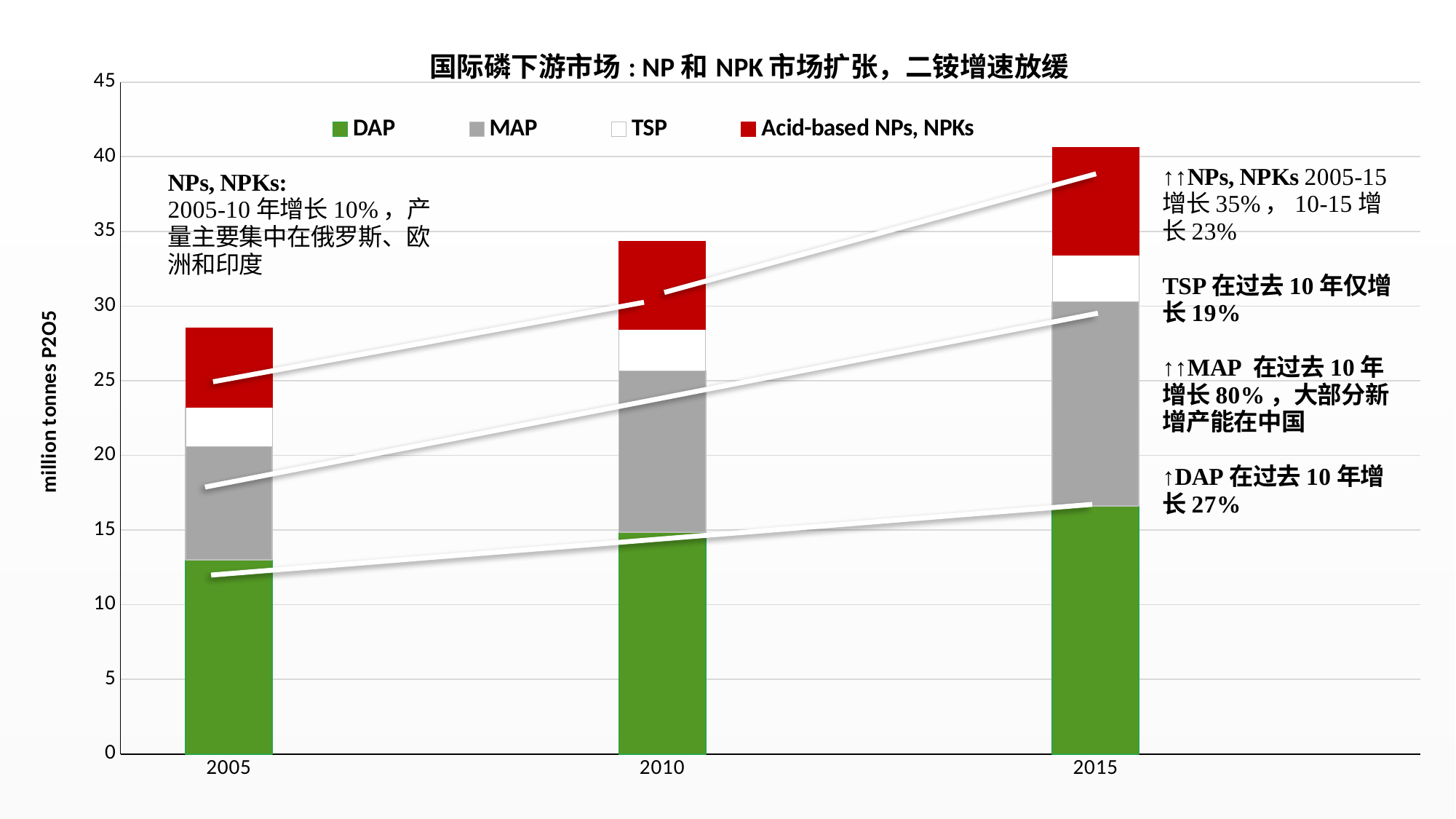
How many years are shown on the x axis of the chart? 3 What is the label on the vertical axis of the chart? million tonnes P2O5 Which year has the shortest stacked bar in the chart? 2005 What kind of chart is shown on the slide? Stacked bar chart Which year has the tallest stacked bar in the chart? 2015 Is the total stacked bar for 2005 greater or less than 30? less Is the total stacked bar for 2015 greater or less than 35? greater Do the total bar heights rise or fall from 2005 to 2015? Rise Which is larger, the MAP segment in 2005 or the MAP segment in 2015? 2015 Is the DAP segment for 2015 greater or less than 15? greater How many series does the chart legend list? 4